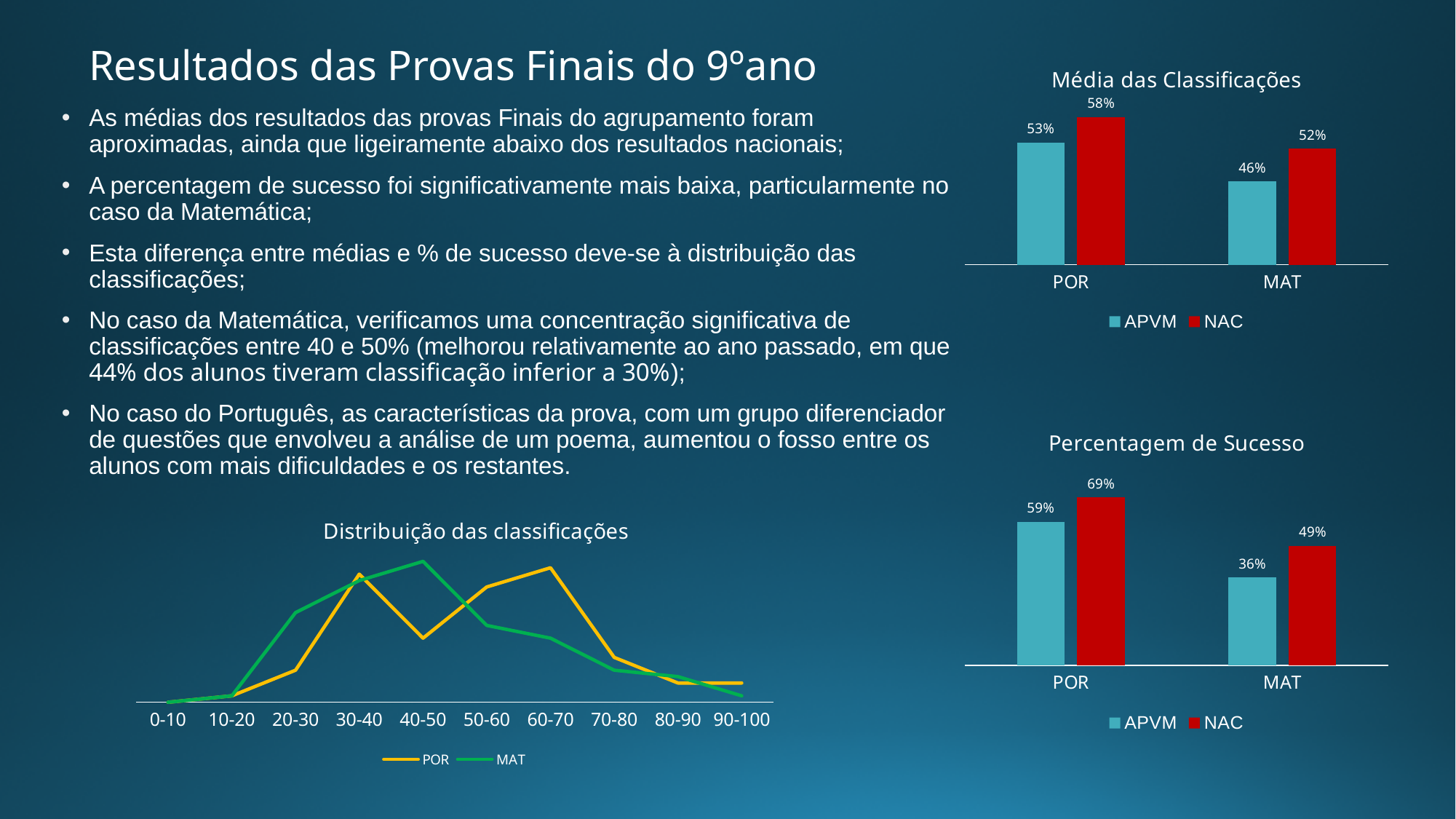
In the 'Percentagem de Sucesso' chart, what is the APVM value for MAT? 36% In the 'Média das Classificações' chart, what is the difference between the NAC and APVM values for MAT? 6% In the 'Média das Classificações' chart, what is the APVM value for POR? 53% In the 'Percentagem de Sucesso' chart, which bar is the lowest? APVM for MAT In the 'Percentagem de Sucesso' chart, what is the NAC value for POR? 69% In the 'Distribuição das classificações' chart, which series is drawn in green? MAT In the 'Média das Classificações' chart, which series has the higher value for POR, APVM or NAC? NAC In the 'Média das Classificações' chart, what is the NAC value for MAT? 52% How many series does the legend of the 'Percentagem de Sucesso' chart list? 2 How many categories are shown on the x axis of the 'Distribuição das classificações' chart? 10 What kind of chart is 'Distribuição das classificações'? Line chart In the 'Percentagem de Sucesso' chart, what is the difference between the NAC and APVM values for POR? 10%